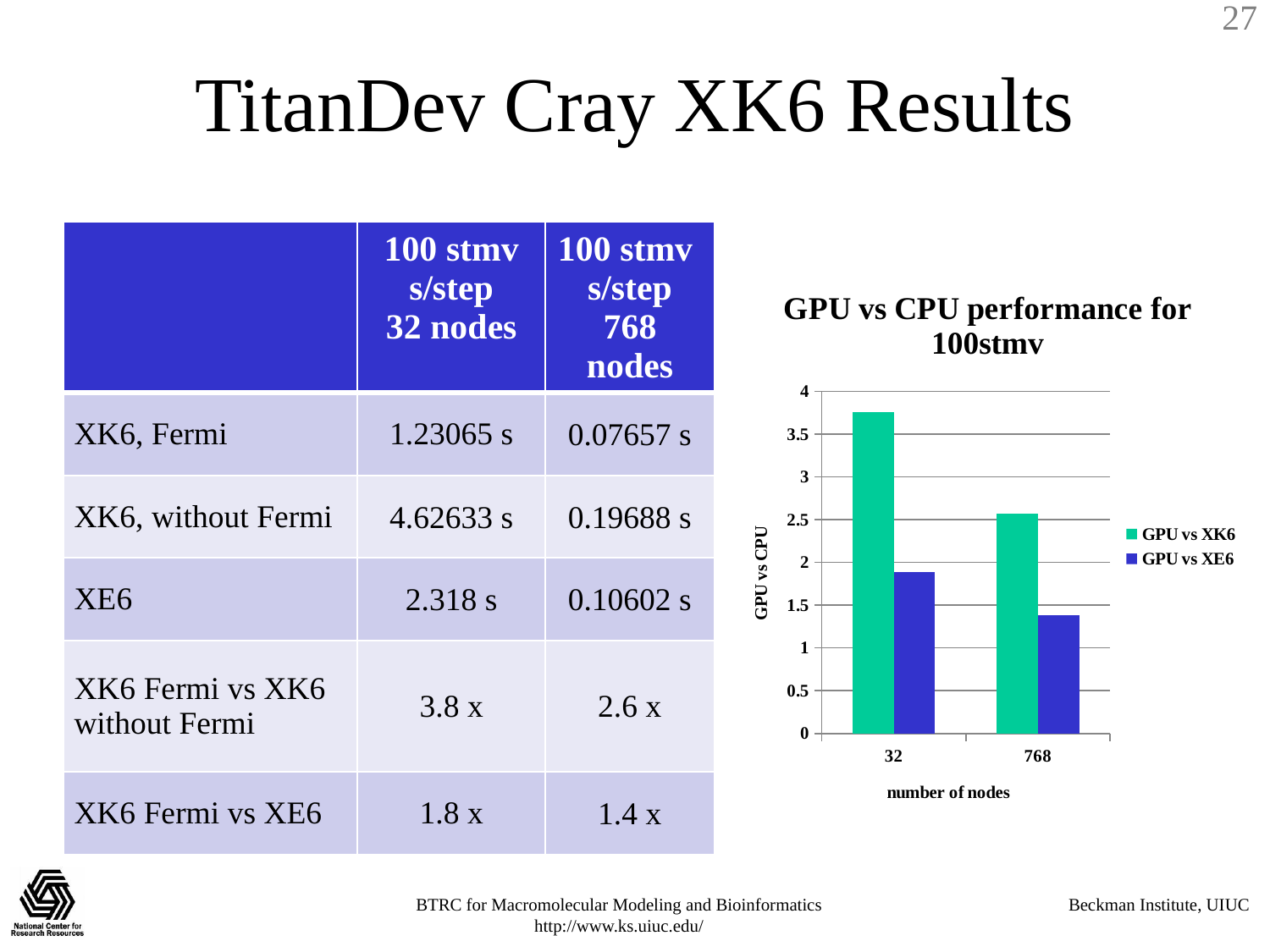
Is the value for GPU vs XK6 at 768 nodes greater or less than 3? less How many node-count categories are shown on the x axis of the chart? 2 What is the label of the chart's x axis? number of nodes Which bar in the chart is the tallest? GPU vs XK6 at 32 nodes Is the value for GPU vs XE6 at 32 nodes greater or less than 1.5? greater Is the value for GPU vs XK6 at 32 nodes greater or less than 3.5? greater Do the GPU vs XK6 values rise or fall from 32 nodes to 768 nodes? fall Which series has the higher value at 768 nodes, GPU vs XK6 or GPU vs XE6? GPU vs XK6 How many series does the chart legend list? 2 What kind of chart is shown on the slide? bar chart What is the title of the chart? GPU vs CPU performance for 100stmv